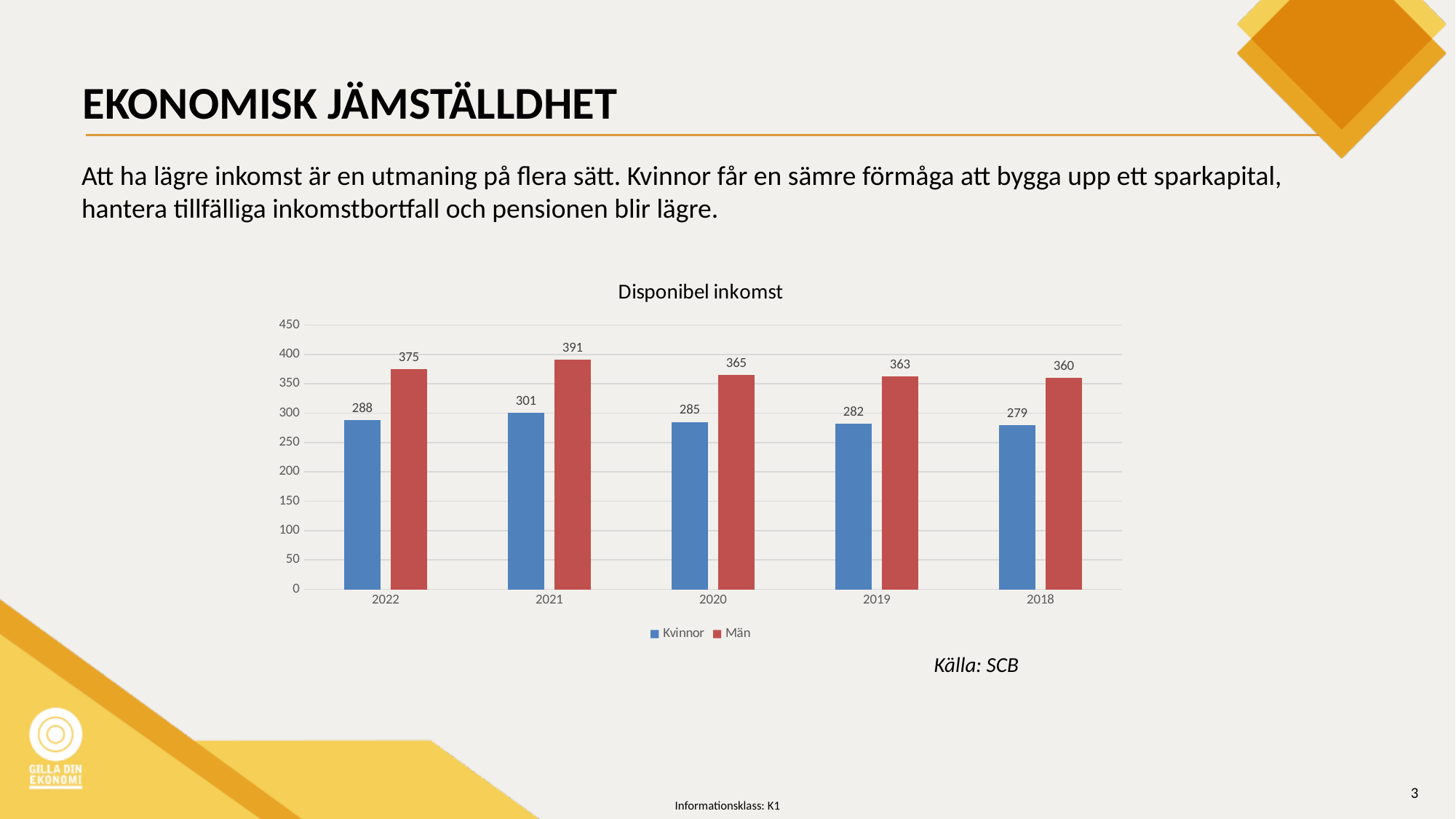
How many series does the legend list? 2 What is the value for Kvinnor in 2018? 279 What is the value for Kvinnor in 2022? 288 Which is larger, the value for Män in 2019 or the value for Män in 2018? Män in 2019 How many years are shown on the x axis? 5 What is the value for Män in 2021? 391 In which year is the value for Män highest? 2021 What kind of chart is shown? Bar chart What is the difference between Män and Kvinnor in 2020? 80 In which year is the value for Kvinnor lowest? 2018 What is the title of the chart? Disponibel inkomst What is the difference between the Kvinnor values for 2021 and 2018? 22